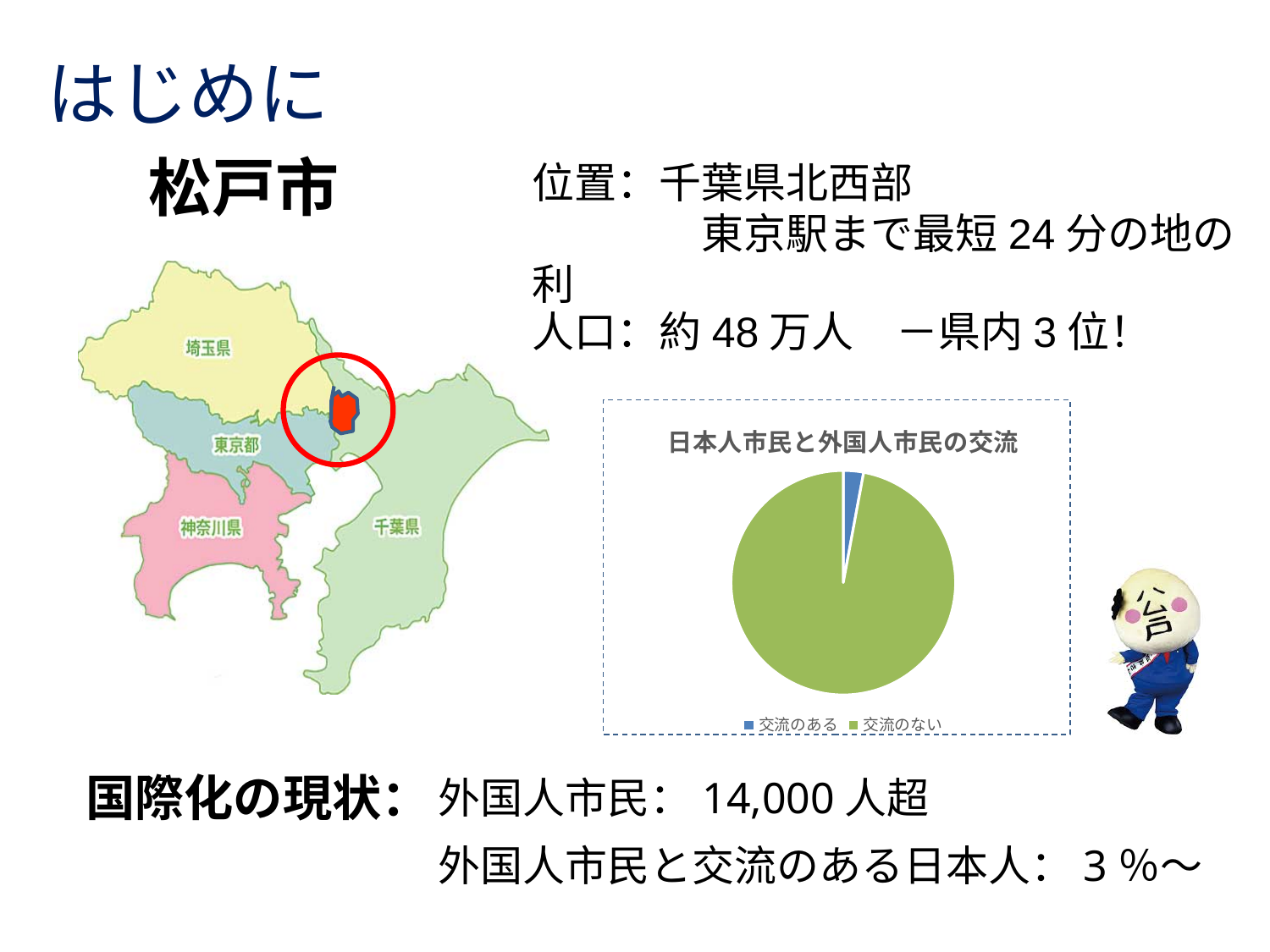
In the pie chart, which is larger: 交流のある or 交流のない? 交流のない How many entries does the pie chart's legend list? 2 Is the share of 交流のない in the pie chart greater or less than 50%? greater Which slice of the pie chart is the largest? 交流のない How many slices does the pie chart have? 2 What is the title of the pie chart? 日本人市民と外国人市民の交流 What colour is the 交流のある slice in the pie chart? blue Is the share of 交流のある in the pie chart greater or less than 25%? less What kind of chart is shown on the slide? pie chart Which slice of the pie chart is the smallest? 交流のある